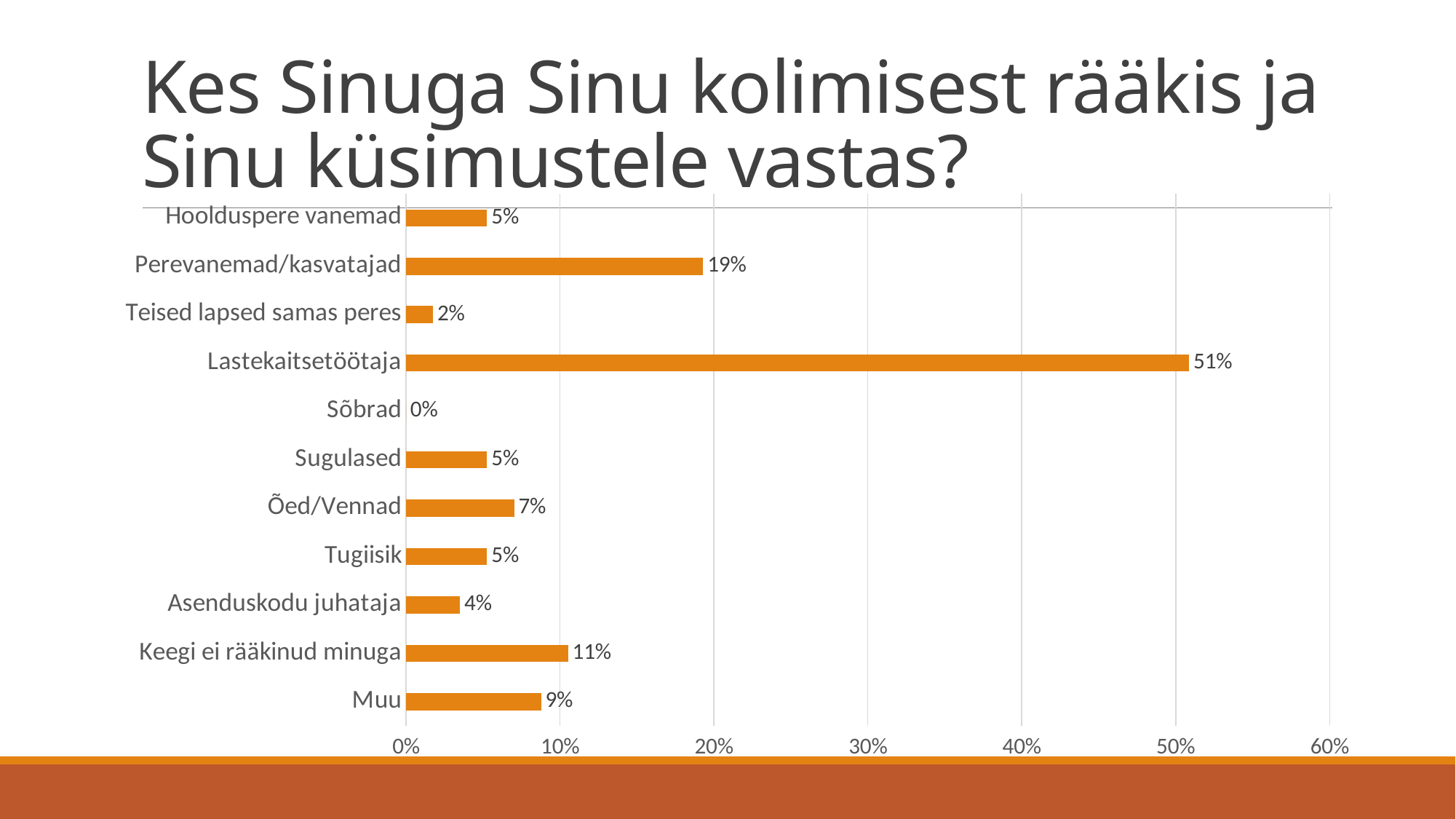
How many categories are shown in the chart? 11 What is the title of the slide? Kes Sinuga Sinu kolimisest rääkis ja Sinu küsimustele vastas? What is the value for Teised lapsed samas peres? 2% What kind of chart is shown on the slide? bar chart Which is larger, the value for Muu or the value for Õed/Vennad? Muu What is the value for Perevanemad/kasvatajad? 19% Which category has the highest value? Lastekaitsetöötaja Is the value for Lastekaitsetöötaja greater or less than 50%? greater What is the value for Keegi ei rääkinud minuga? 11% What is the value for Lastekaitsetöötaja? 51% Which category has the lowest value? Sõbrad What is the difference between the values for Lastekaitsetöötaja and Perevanemad/kasvatajad? 32%